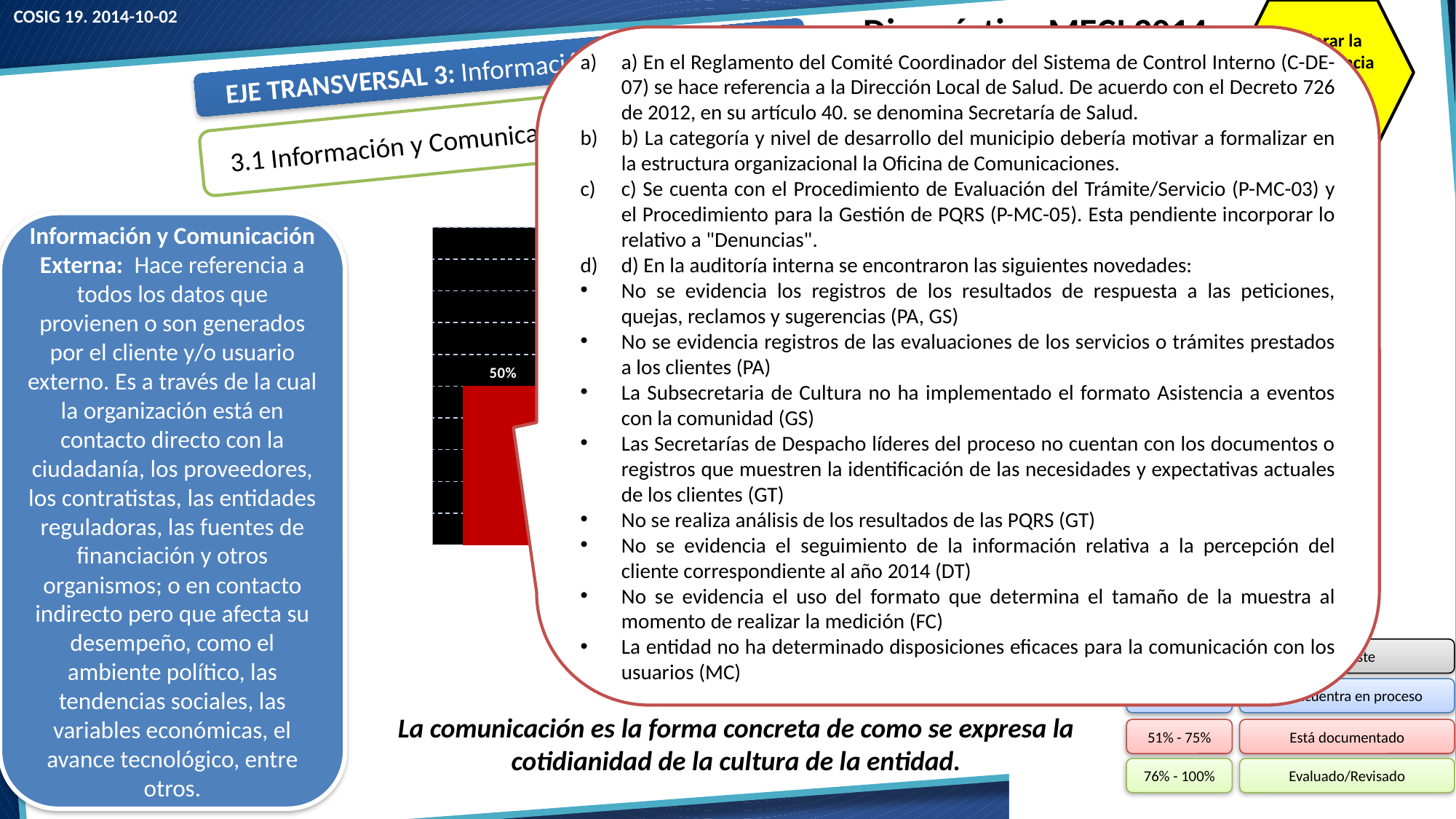
What colour is the visible bar in the chart? red Is the value shown on the visible red bar greater or less than 25%? greater Is the value shown on the visible red bar greater or less than 75%? less What value is printed as the data label on the visible red bar of the chart? 50% What kind of chart is partially visible behind the callout box? bar chart What is the background colour of the chart's plot area? black